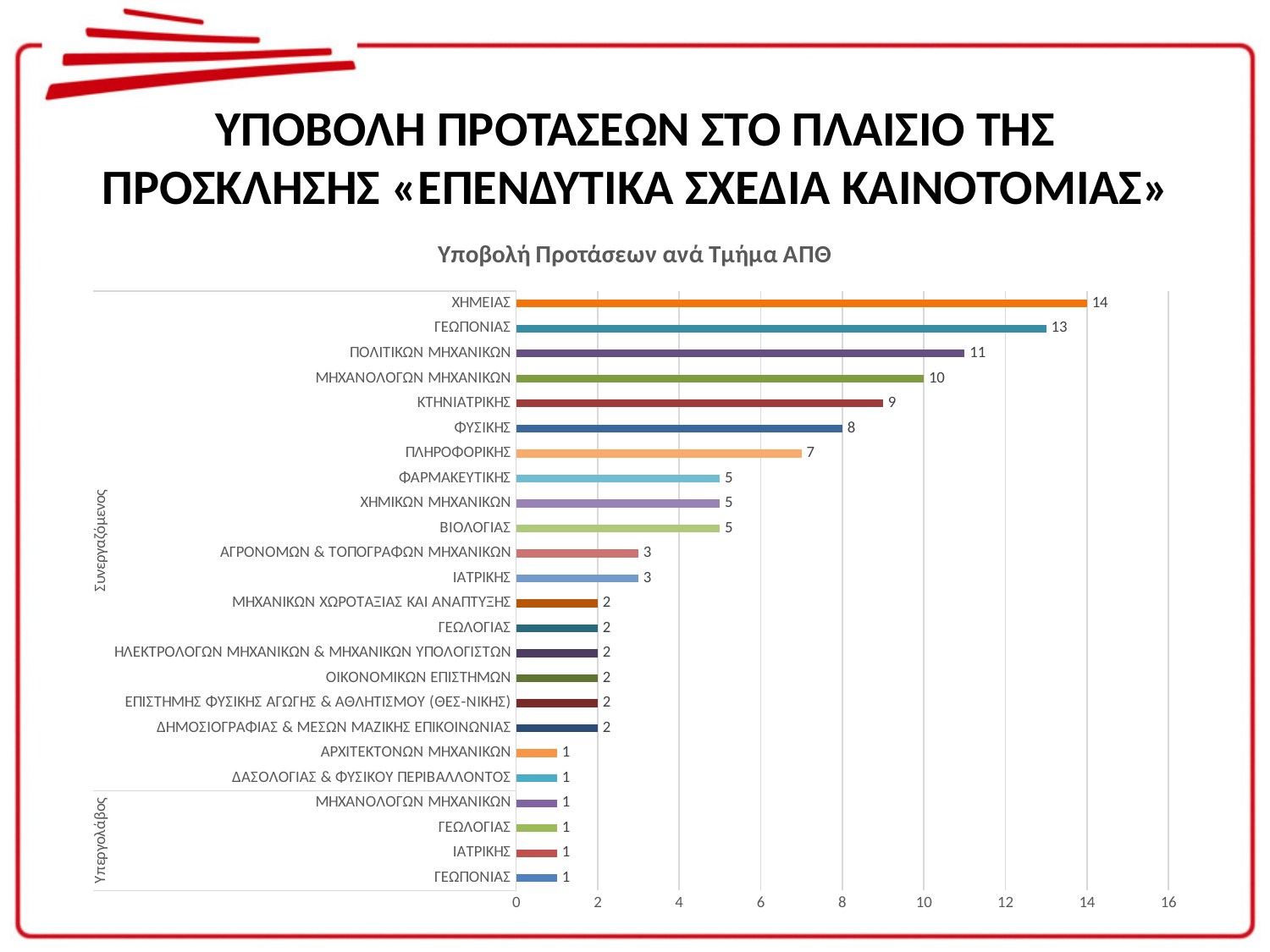
What kind of chart is shown on the slide? bar chart What is the value for ΙΑΤΡΙΚΗΣ under Υπεργολάβος? 1 What is the value for ΧΗΜΕΙΑΣ under Συνεργαζόμενος? 14 Which department has the highest value in the chart? ΧΗΜΕΙΑΣ What is the difference between the values for ΓΕΩΠΟΝΙΑΣ under Συνεργαζόμενος and ΦΥΣΙΚΗΣ? 5 How many bars are plotted in the chart in total? 24 What is the value for ΚΤΗΝΙΑΤΡΙΚΗΣ? 9 Which is larger, the value for ΠΟΛΙΤΙΚΩΝ ΜΗΧΑΝΙΚΩΝ or the value for ΜΗΧΑΝΟΛΟΓΩΝ ΜΗΧΑΝΙΚΩΝ under Συνεργαζόμενος? ΠΟΛΙΤΙΚΩΝ ΜΗΧΑΝΙΚΩΝ How many categories are listed under the Υπεργολάβος group? 4 What is the title of the chart? Υποβολή Προτάσεων ανά Τμήμα ΑΠΘ What is the value for ΠΛΗΡΟΦΟΡΙΚΗΣ? 7 What is the difference between the values for ΧΗΜΕΙΑΣ and ΒΙΟΛΟΓΙΑΣ? 9